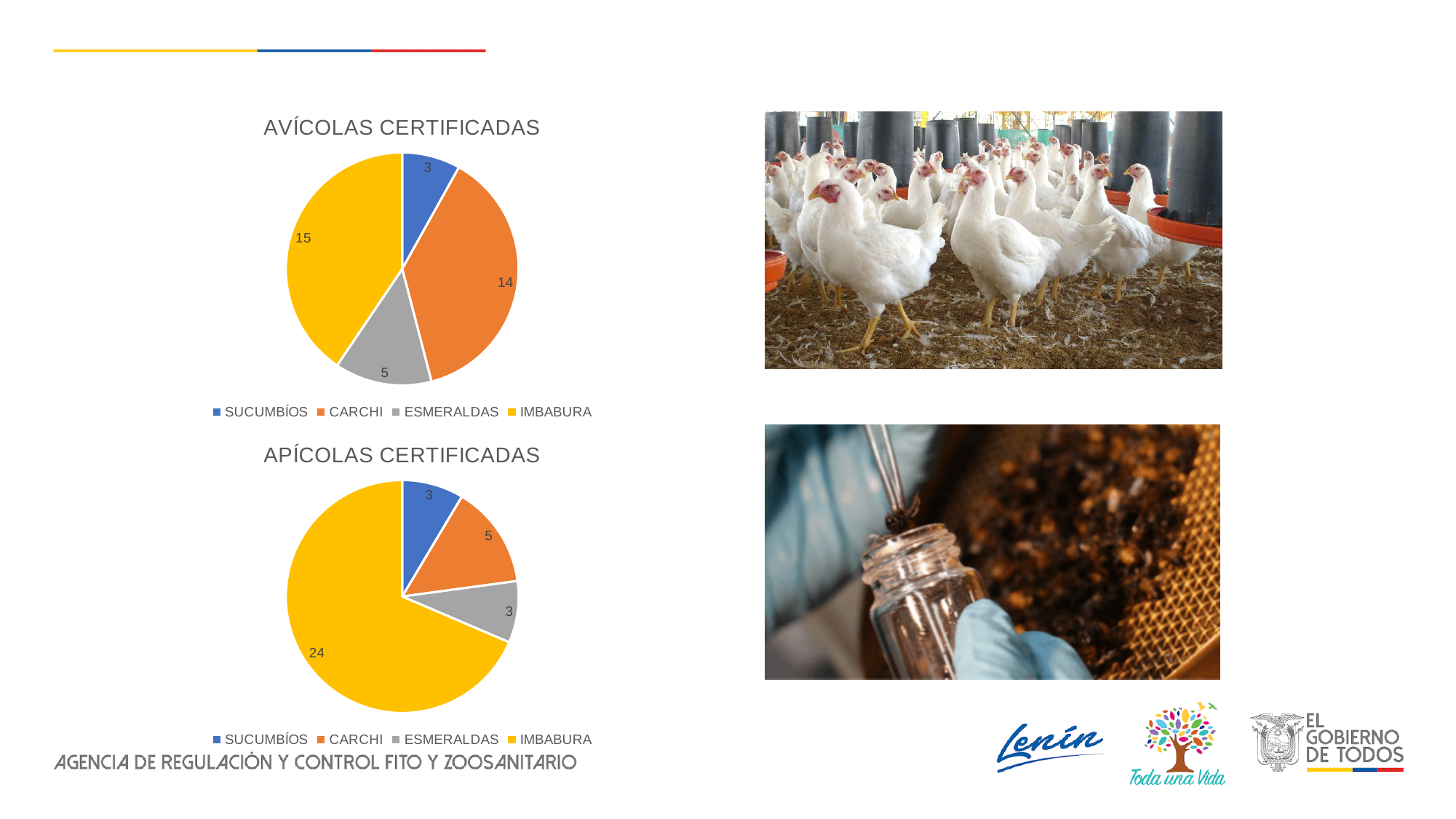
In the APÍCOLAS CERTIFICADAS chart, which category has the highest value? IMBABURA In the APÍCOLAS CERTIFICADAS chart, what is the value for CARCHI? 5 In the AVÍCOLAS CERTIFICADAS chart, which category has the lowest value? SUCUMBÍOS In the APÍCOLAS CERTIFICADAS chart, what is the difference between the values for IMBABURA and CARCHI? 19 In the AVÍCOLAS CERTIFICADAS chart, which category has the highest value? IMBABURA What kind of chart is the APÍCOLAS CERTIFICADAS chart? Pie chart In the APÍCOLAS CERTIFICADAS chart, what is the value for IMBABURA? 24 In the AVÍCOLAS CERTIFICADAS chart, what is the value for ESMERALDAS? 5 How many categories does the AVÍCOLAS CERTIFICADAS chart show? 4 In the AVÍCOLAS CERTIFICADAS chart, what is the difference between the values for IMBABURA and CARCHI? 1 In the AVÍCOLAS CERTIFICADAS chart, what is the value for CARCHI? 14 In the APÍCOLAS CERTIFICADAS chart, which is larger, the value for CARCHI or the value for ESMERALDAS? CARCHI